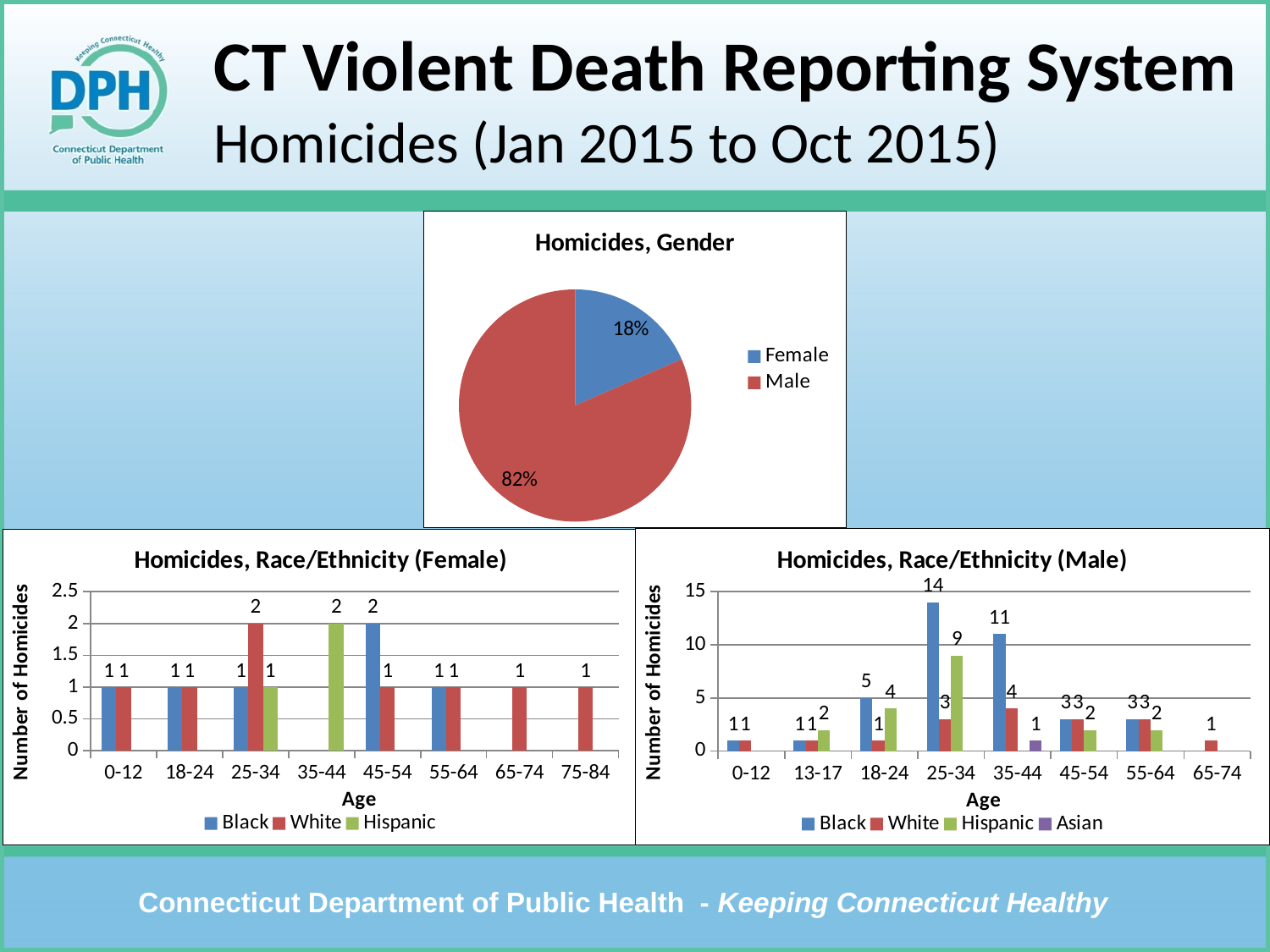
How many age groups are shown on the x axis of the "Homicides, Race/Ethnicity (Female)" chart? 8 In the "Homicides, Race/Ethnicity (Male)" chart, how many series does the legend list? 4 In the "Homicides, Race/Ethnicity (Female)" chart, what is the value for White in the 25-34 age group? 2 In the "Homicides, Race/Ethnicity (Male)" chart, which age group has the highest value for Black? 25-34 In the "Homicides, Race/Ethnicity (Male)" chart, what is the value for Hispanic in the 25-34 age group? 9 In the "Homicides, Gender" pie chart, what share of homicides is Female? 18% In the "Homicides, Race/Ethnicity (Male)" chart, what is the difference between the Black values for the 25-34 and 35-44 age groups? 3 In the "Homicides, Race/Ethnicity (Male)" chart, which is larger in the 18-24 age group: Black or Hispanic? Black What kind of chart is "Homicides, Race/Ethnicity (Female)"? Bar chart In the "Homicides, Race/Ethnicity (Male)" chart, what is the value for Black in the 25-34 age group? 14 In the "Homicides, Gender" pie chart, what share of homicides is Male? 82% What kind of chart is "Homicides, Gender"? Pie chart